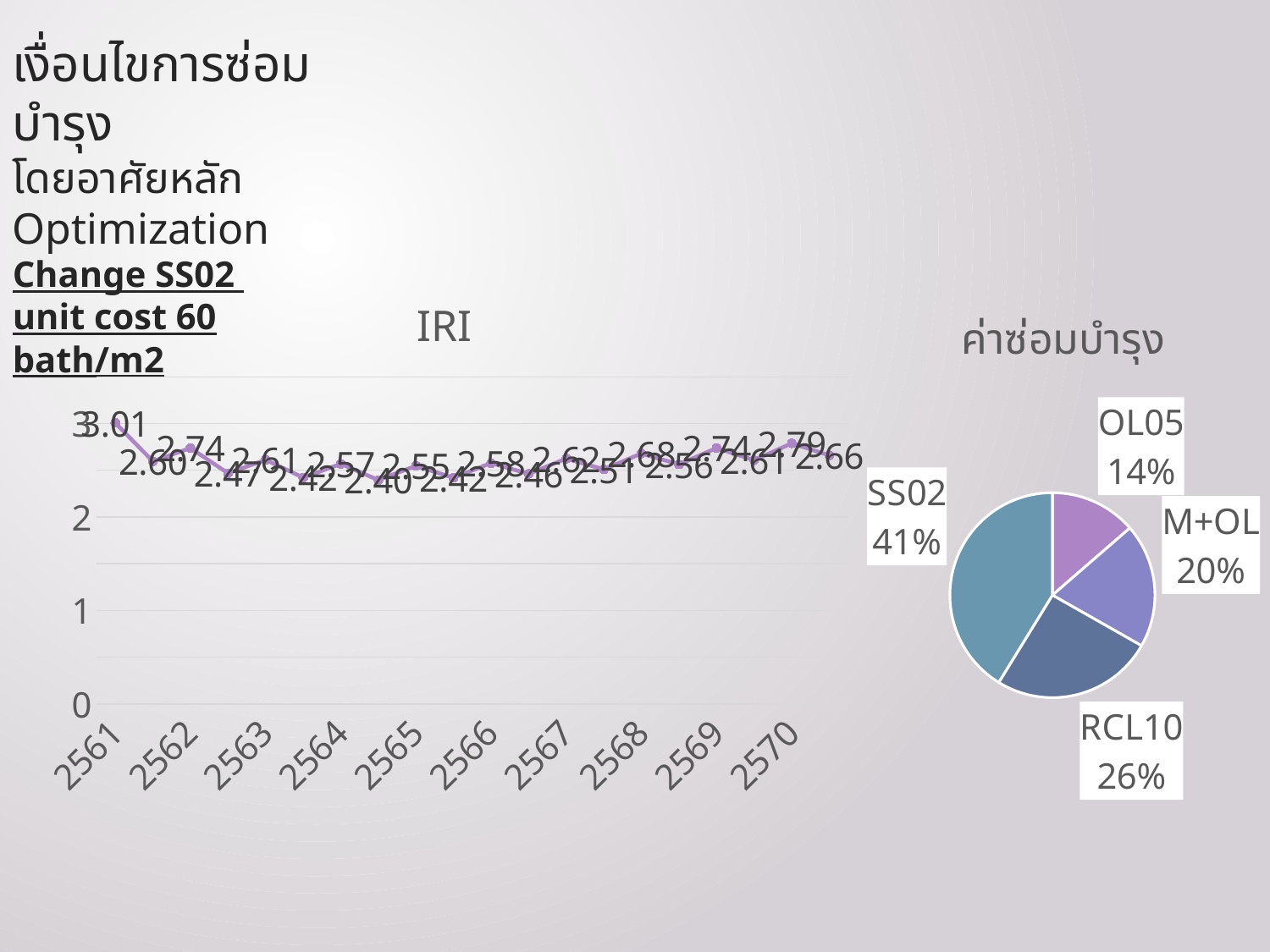
In the pie chart titled "ค่าซ่อมบำรุง", what is the difference between the shares of SS02 and RCL10? 15% In the pie chart titled "ค่าซ่อมบำรุง", which is larger, RCL10 or M+OL? RCL10 What kind of chart is the chart titled "IRI"? line chart In the pie chart titled "ค่าซ่อมบำรุง", how many slices are there? 4 In the line chart titled "IRI", is the value for 2565 greater or less than 2? greater In the pie chart titled "ค่าซ่อมบำรุง", which category has the largest share? SS02 In the pie chart titled "ค่าซ่อมบำรุง", what share does SS02 have? 41% In the line chart titled "IRI", how many years are labelled on the x axis? 10 In the pie chart titled "ค่าซ่อมบำรุง", which category has the smallest share? OL05 In the pie chart titled "ค่าซ่อมบำรุง", what share does OL05 have? 14% What kind of chart is the chart titled "ค่าซ่อมบำรุง"? pie chart In the pie chart titled "ค่าซ่อมบำรุง", what share does RCL10 have? 26%